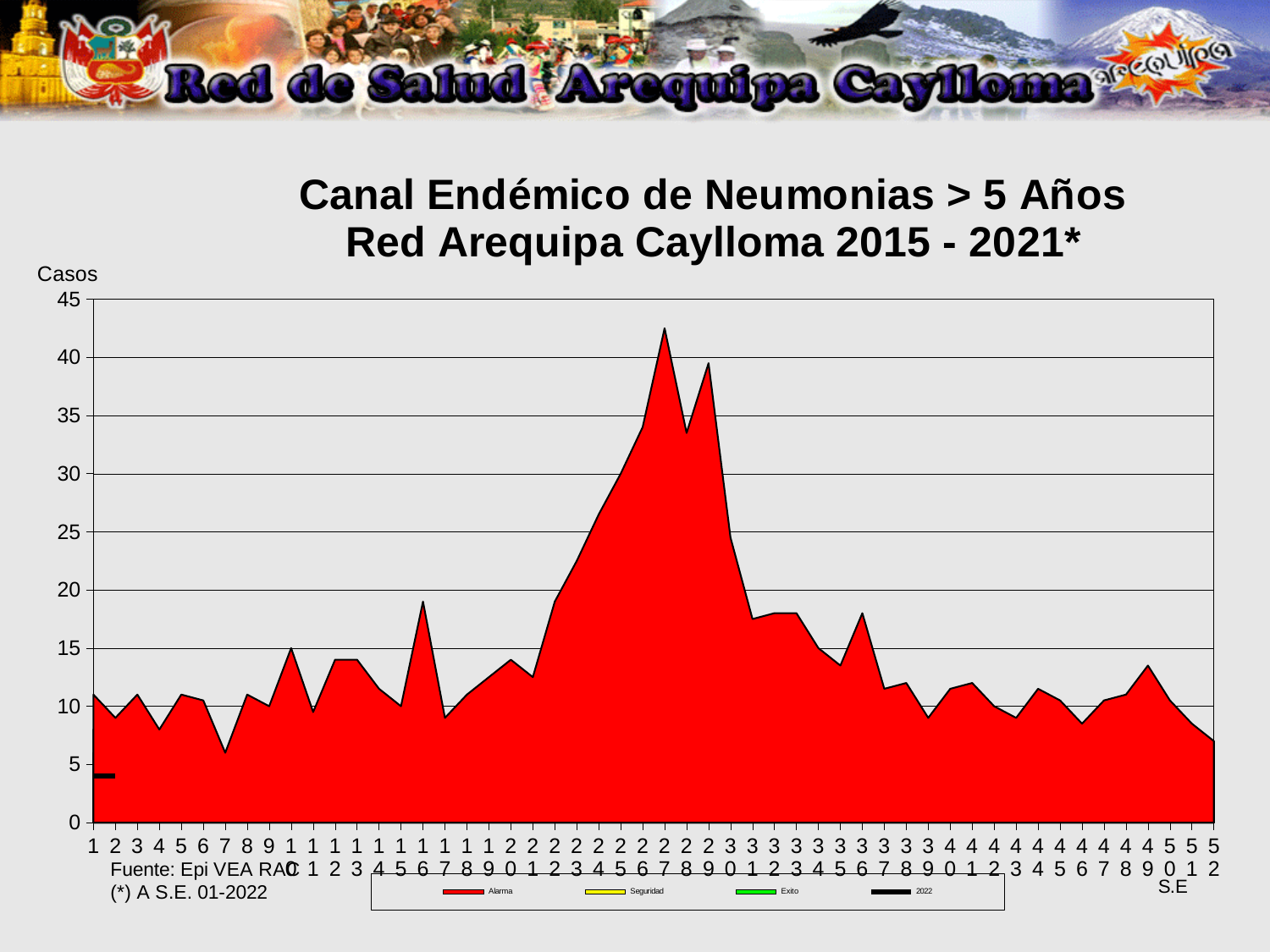
How many epidemiological weeks (S.E.) are shown along the x axis? 52 How many series does the legend list? 4 Is the Alarma value at week 16 greater or less than 15? greater What is the label on the y axis of the chart? Casos Is the Alarma value at week 52 greater or less than 10? less What kind of chart is shown on the slide? Area chart Is the Alarma value at week 7 greater or less than 10? less Which legend entry is drawn in black? 2022 Which week has the larger Alarma value, week 27 or week 29? Week 27 At which week does the Alarma curve reach its highest value? 27 Does the Alarma curve rise or fall between week 20 and week 27? Rise